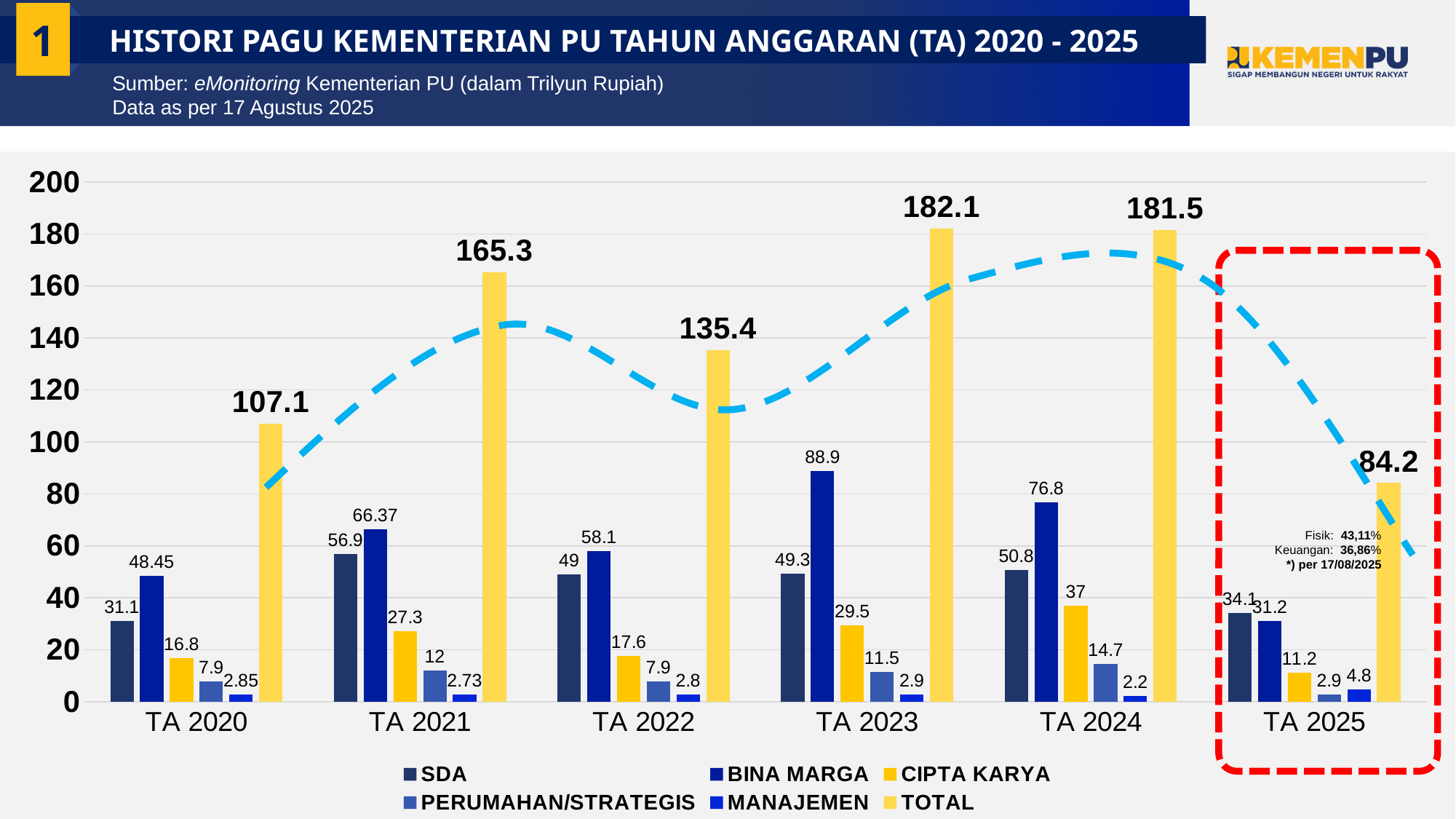
How many fiscal years (TA) are shown on the x axis? 6 Which year has the lowest TOTAL value? TA 2025 What is the PERUMAHAN/STRATEGIS value for TA 2021? 12 What is the difference between the TOTAL values for TA 2024 and TA 2025? 97.3 What is the CIPTA KARYA value for TA 2024? 37 What is the TOTAL value for TA 2023? 182.1 Which year has the highest TOTAL value? TA 2023 What kind of chart is this? Bar chart What is the BINA MARGA value for TA 2021? 66.37 What is the SDA value for TA 2025? 34.1 How many series does the legend list? 6 Which is larger, the BINA MARGA value for TA 2023 or for TA 2024? TA 2023